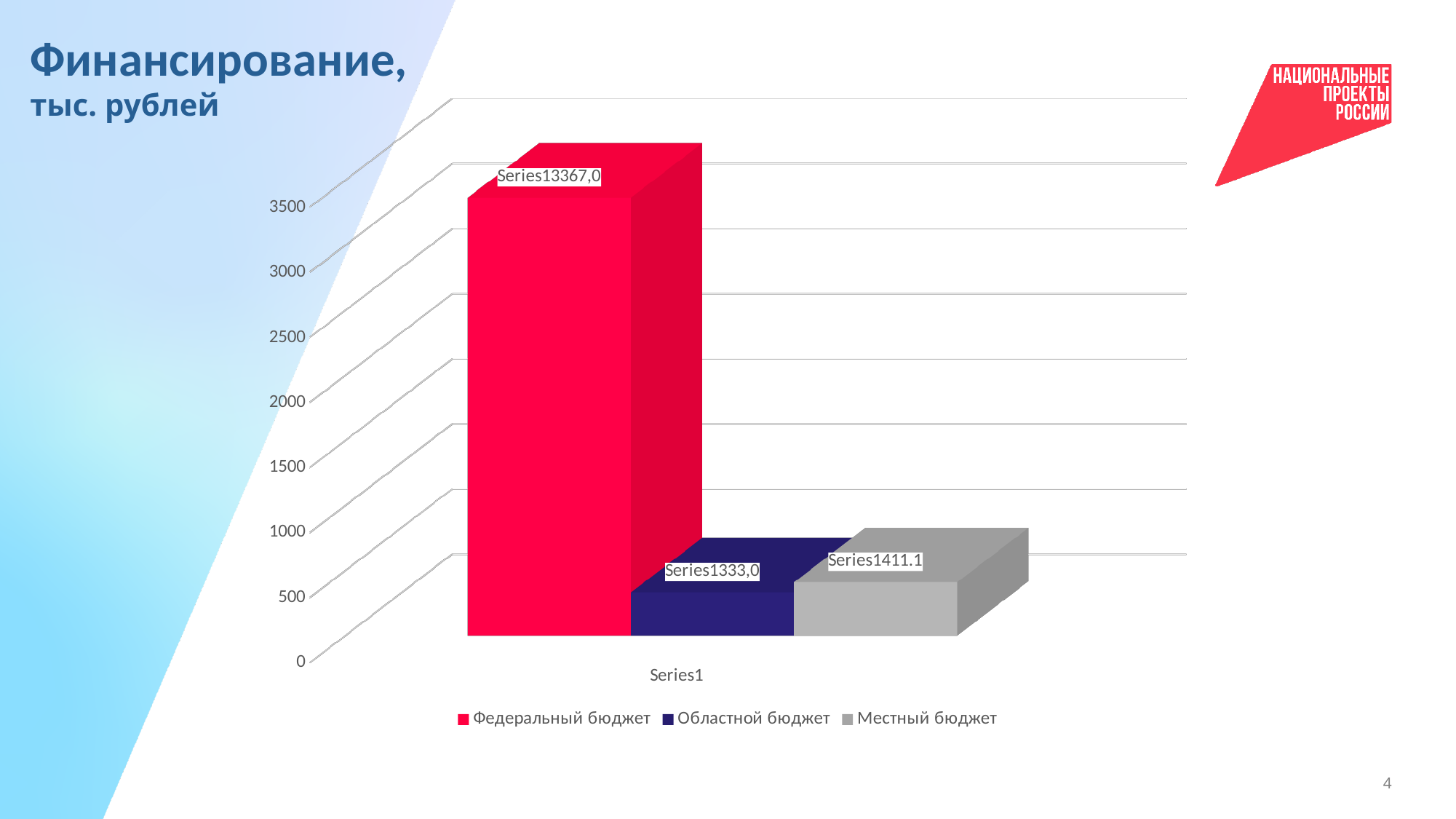
Which series has the lowest bar? Областной бюджет Is the value for Федеральный бюджет greater or less than 2500? greater What is the title of the slide above the chart? Финансирование, тыс. рублей Is the value for Местный бюджет greater or less than 1000? less Is the value for Областной бюджет greater or less than 1000? less How many bars are plotted in the chart? 3 Which is larger, the bar for Федеральный бюджет or the bar for Местный бюджет? Федеральный бюджет What colour is the bar for Федеральный бюджет? red Which is larger, the bar for Местный бюджет or the bar for Областной бюджет? Местный бюджет Which series has the highest bar? Федеральный бюджет How many series does the legend list? 3 What kind of chart is shown on the slide? bar chart